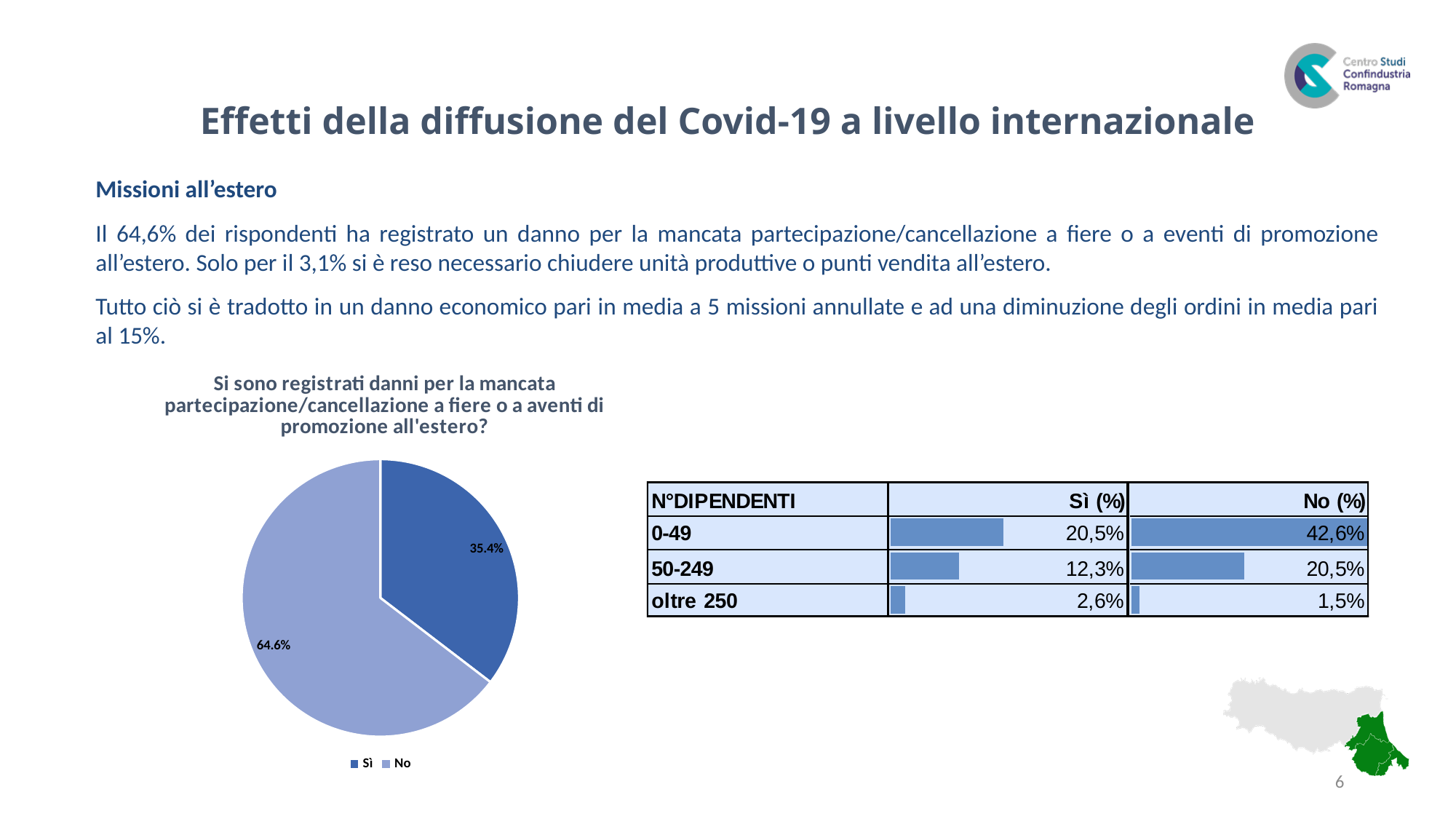
How many slices does the pie chart have? 2 In the table on the right, what is the 'No (%)' value for the '50-249' employee class? 20,5% In the pie chart's legend, which colour represents 'Sì'? dark blue In the pie chart, what share is labelled for the 'Sì' slice? 35.4% In the pie chart, which slice is larger, 'Sì' or 'No'? No In the pie chart, what is the difference between the 'No' share and the 'Sì' share? 29.2% What kind of chart is shown on the left of the slide? pie chart In the pie chart, what share is labelled for the 'No' slice? 64.6% How many entries does the pie chart's legend list? 2 In the table on the right, which employee class has the highest 'No (%)' value? 0-49 In the table on the right, what is the 'Sì (%)' value for the '0-49' employee class? 20,5% In the table on the right, which employee class has the lowest 'Sì (%)' value? oltre 250